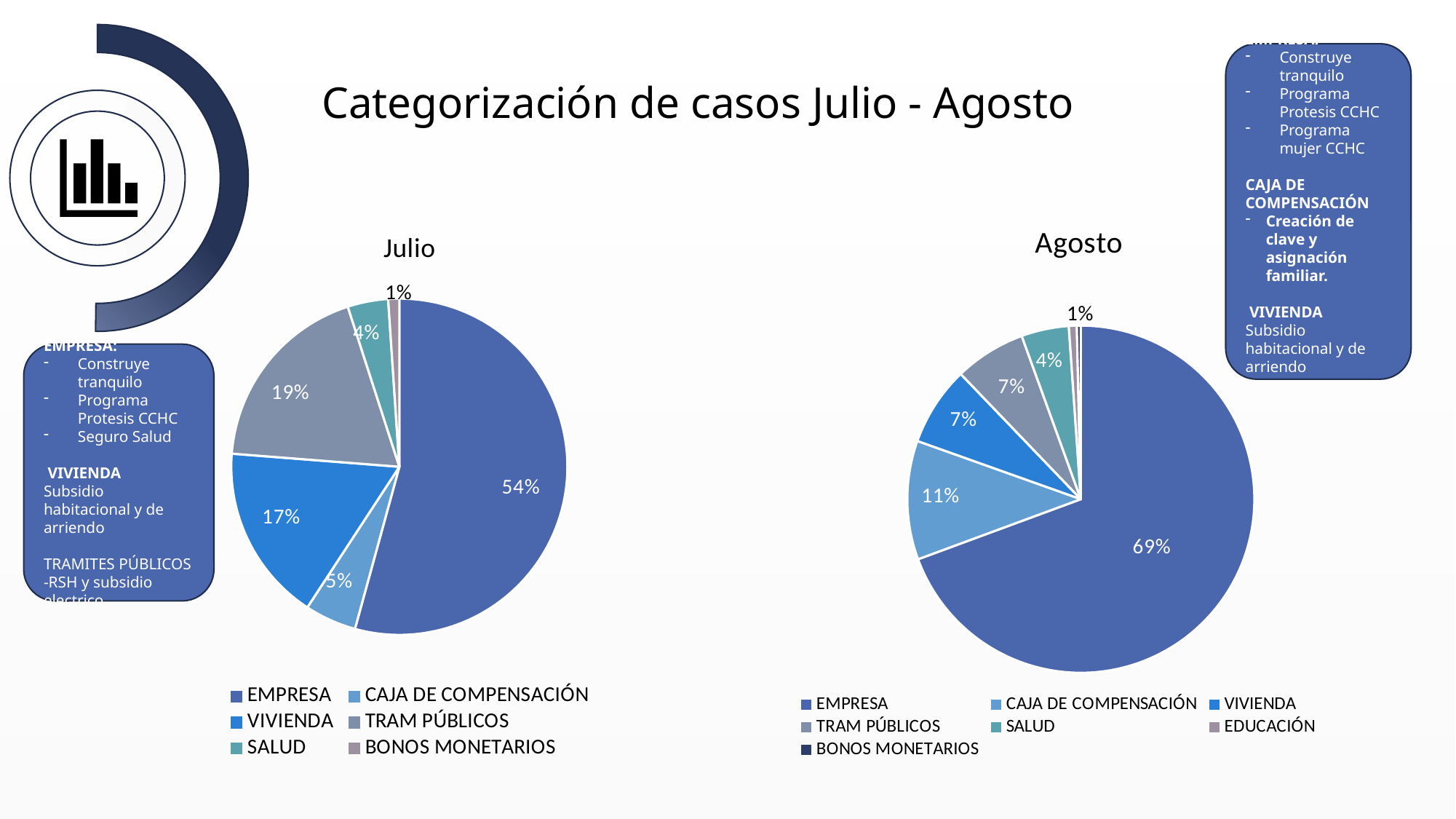
In the Julio pie chart, what percentage is shown for EMPRESA? 54% In the Julio pie chart, which category has the largest share? EMPRESA In the Agosto pie chart, what percentage is shown for CAJA DE COMPENSACIÓN? 11% In the Agosto pie chart, what percentage is shown for SALUD? 4% In the Julio pie chart, which category has the smallest share? BONOS MONETARIOS In the Julio pie chart, what percentage is shown for TRAM PÚBLICOS? 19% In the Julio pie chart, which is larger: VIVIENDA or CAJA DE COMPENSACIÓN? VIVIENDA What type of chart is used for Julio and Agosto? Pie chart In the Julio pie chart, what is the difference in percentage points between TRAM PÚBLICOS and VIVIENDA? 2 percentage points By how many percentage points did the EMPRESA share increase from the Julio chart to the Agosto chart? 15 percentage points In the Agosto pie chart, what percentage is shown for EMPRESA? 69% How many categories does the legend of the Agosto pie chart list? 7